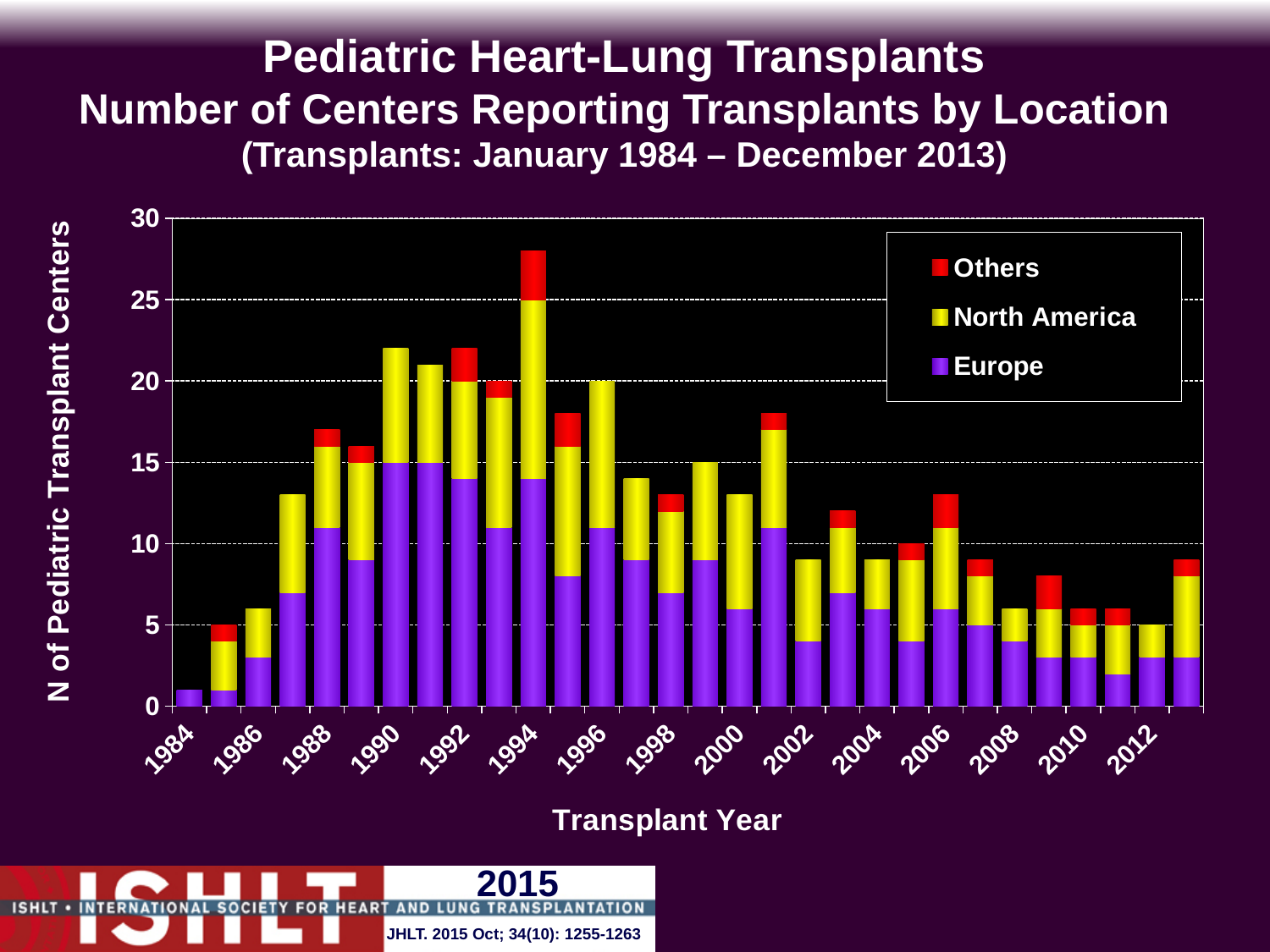
Which transplant year has the highest total number of pediatric transplant centers? 1994 Which year has a larger total number of centers, 1990 or 2000? 1990 What colour represents Europe in the chart? Purple Is the total number of centers for 1995 greater or less than 25? less How many centers in Europe reported transplants in 1990? 15 Is the total number of centers for 1984 greater or less than 5? less What kind of chart is shown on the slide? Stacked bar chart How many series does the legend list? 3 Which transplant year has the lowest total number of pediatric transplant centers? 1984 Do the total numbers of centers generally rise or fall from 1995 to 2013? Fall Which three locations are listed in the legend? Others, North America, Europe Is the total number of centers for 2002 greater or less than 10? less